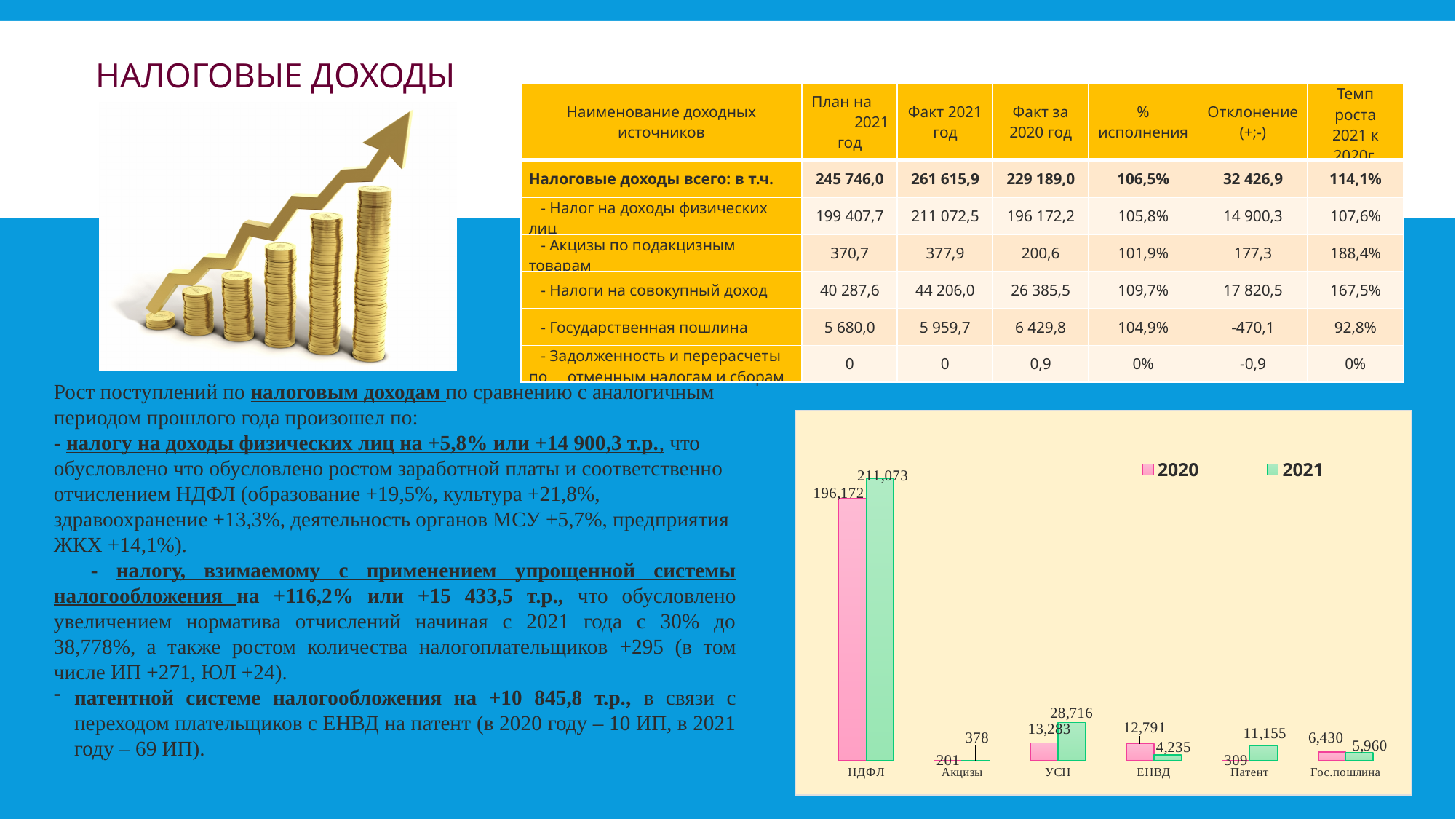
For ЕНВД, which year has the larger value in the chart, 2020 or 2021? 2020 How many series does the chart legend list? 2 What is the difference between the 2021 and 2020 values for УСН in the chart? 15,433 How many categories are shown on the x axis of the chart? 6 What is the 2021 value for Патент in the chart? 11,155 Which colour represents the 2021 series in the chart? green Which category has the lowest 2020 value in the chart? Акцизы For Гос.пошлина, which year has the larger value in the chart, 2020 or 2021? 2020 What is the 2020 value for УСН in the chart? 13,283 What type of chart is shown on the slide? bar chart Which category has the highest 2021 value in the chart? НДФЛ What is the 2021 value for НДФЛ in the chart? 211,073